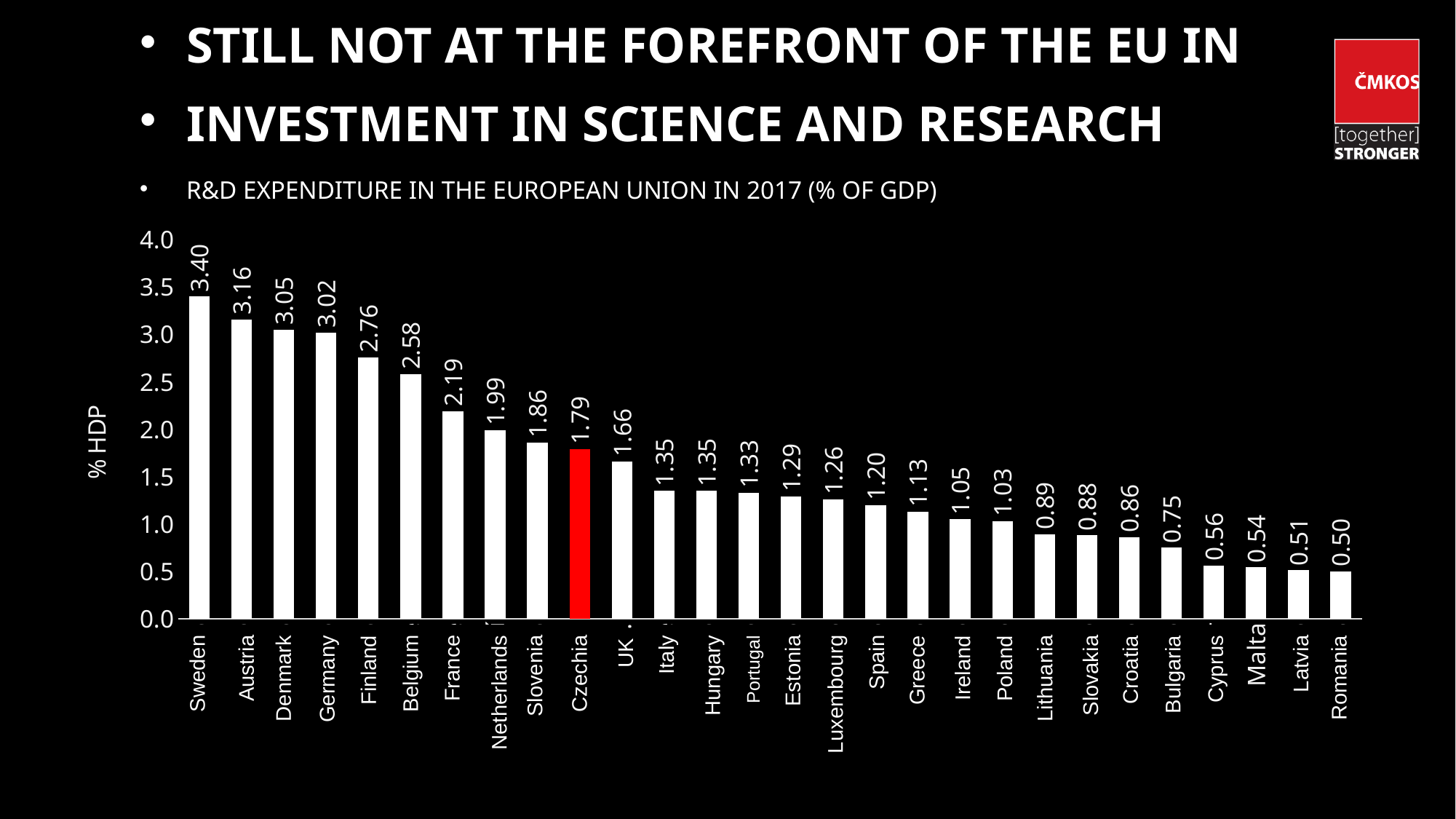
What is the difference between the values for Austria and Denmark? 0.11 Which country has the lowest R&D expenditure in the chart? Romania Which country has the highest R&D expenditure in the chart? Sweden What is the value shown for Germany? 3.02 What is the R&D expenditure value shown for Czechia? 1.79 How many countries are shown in the chart? 28 Is the value for Netherlands greater or less than 1.5? greater What kind of chart is shown on the slide? Bar chart Which has a higher value, Finland or France? Finland What is the value shown for Poland? 1.03 What is the difference between the values for Sweden and Czechia? 1.61 Which country's bar is highlighted in red? Czechia